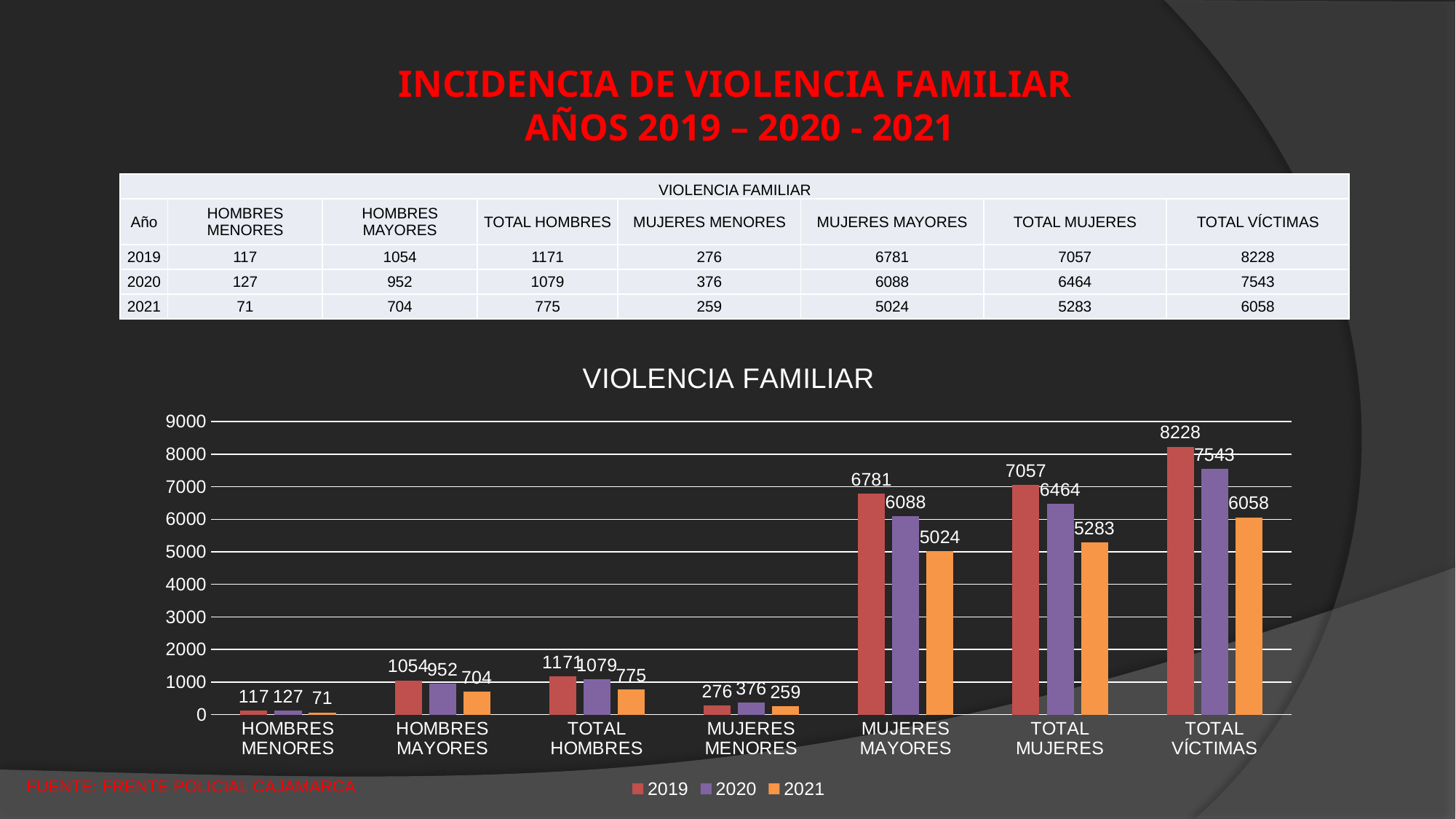
Is the value for TOTAL VÍCTIMAS in 2020 greater or less than 7000? greater What is the value for MUJERES MAYORES in 2021? 5024 How many categories are shown on the x axis of the chart? 7 Which is larger for MUJERES MENORES: the 2019 value or the 2020 value? 2020 Which category has the lowest value for the 2021 series? HOMBRES MENORES What is the value for TOTAL VÍCTIMAS in 2019? 8228 Which category has the highest value for the 2019 series? TOTAL VÍCTIMAS What is the title of the chart? VIOLENCIA FAMILIAR What is the value for HOMBRES MENORES in 2020? 127 What is the difference between the 2019 and 2021 values for TOTAL MUJERES? 1774 How many series does the legend list? 3 What kind of chart is shown on the slide? bar chart